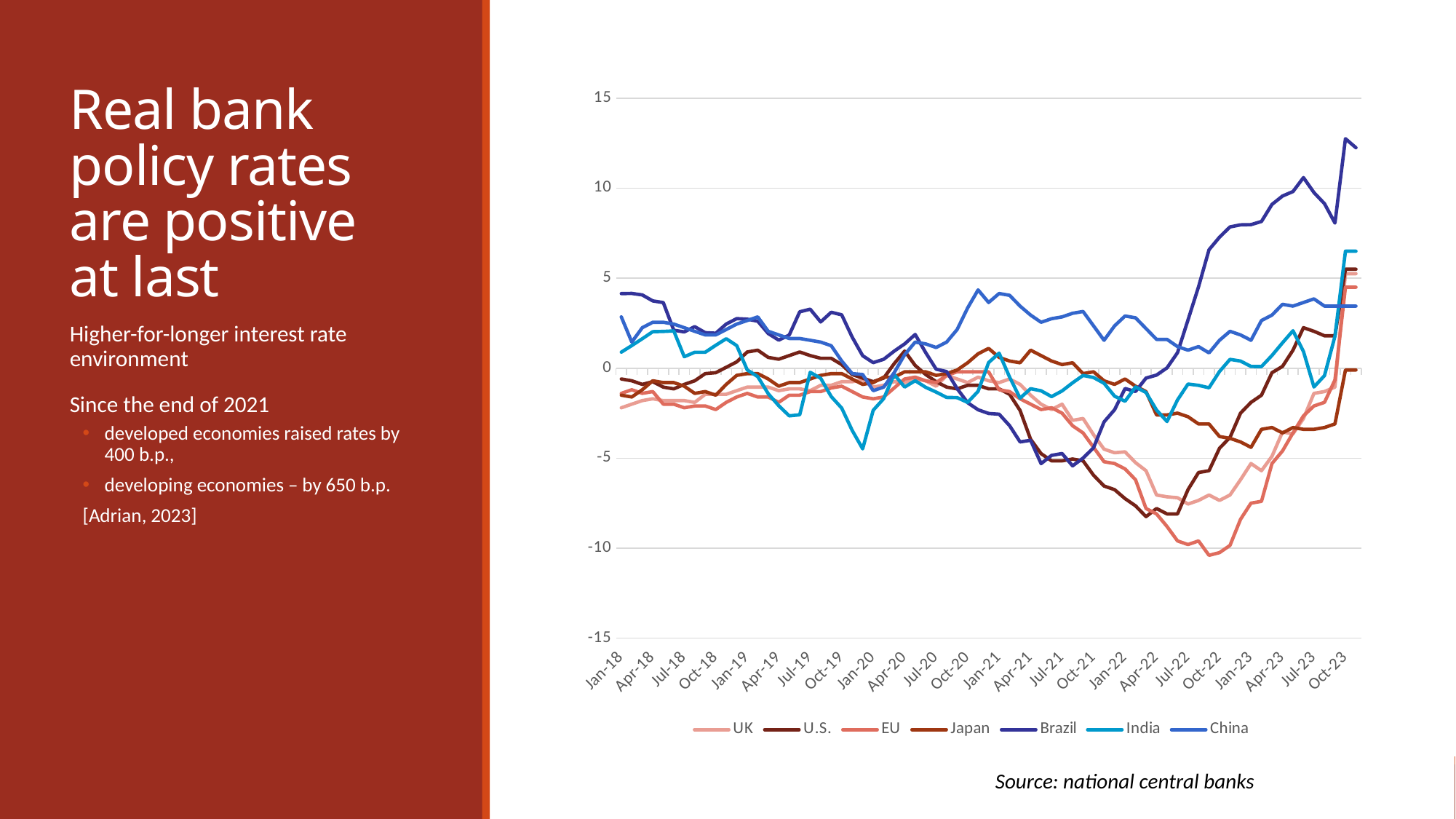
Is the value for China at Jan-21 greater or less than 0? greater How many series does the legend list? 7 Which series has the highest value at Oct-23? Brazil Does the Brazil line rise or fall between Jan-22 and Oct-23? Rise How many date labels are shown on the x axis? 24 At Oct-23, which is larger: the value for Brazil or the value for China? Brazil Is the value for Brazil at Oct-23 greater or less than 10? greater Which series has the lowest value at Oct-22? EU What source is cited below the chart? Source: national central banks Is the value for U.S. at Apr-22 greater or less than -5? less What kind of chart is shown on the slide? Line chart